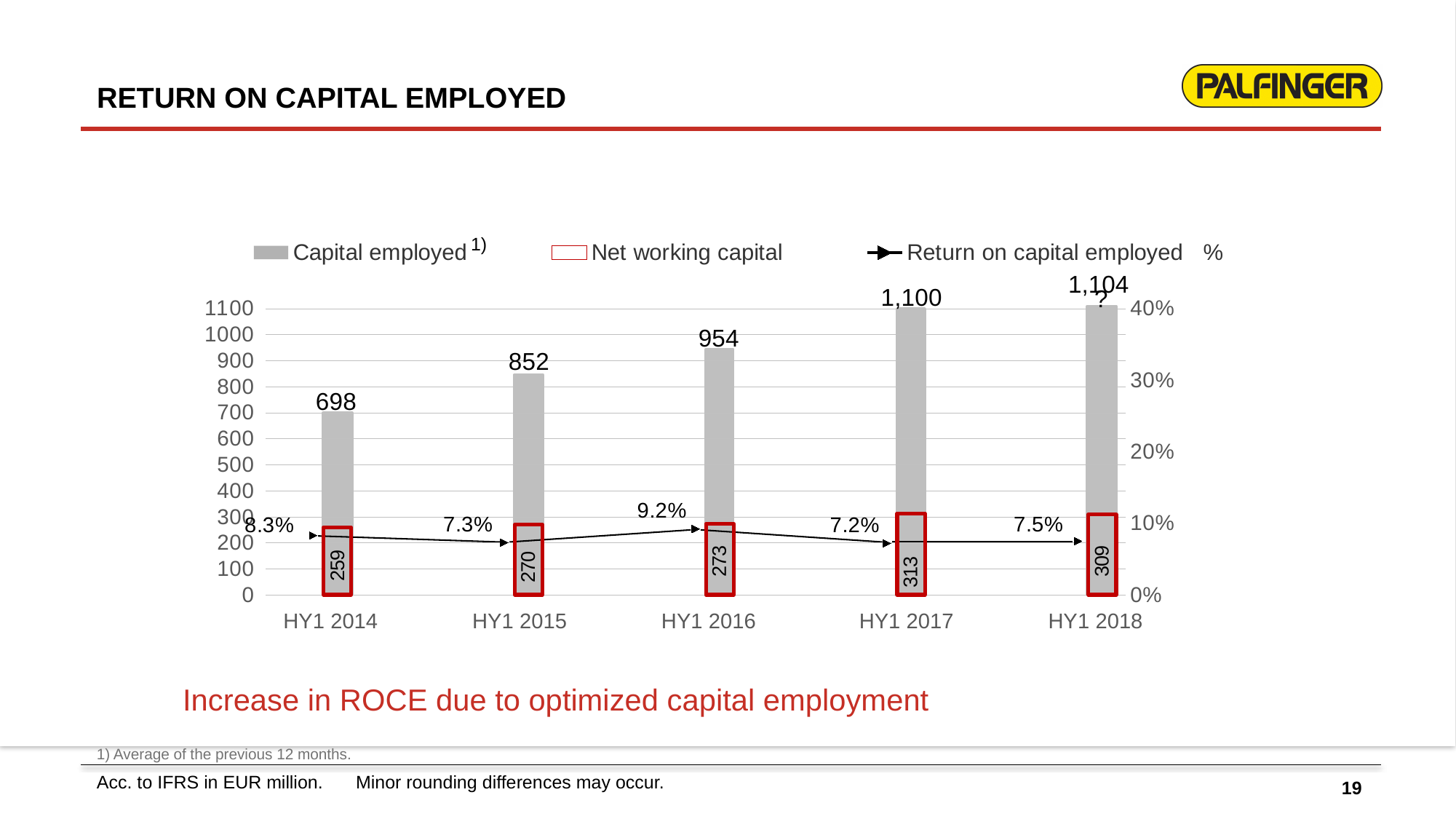
Which period has the highest return on capital employed? HY1 2016 What colour are the capital employed bars? grey Which is larger, the net working capital for HY1 2017 or for HY1 2018? HY1 2017 What is the return on capital employed for HY1 2014? 8.3% What is the net working capital for HY1 2017? 313 Does the capital employed rise or fall from HY1 2014 to HY1 2018? rise What is the difference in capital employed between HY1 2015 and HY1 2014? 154 What is the difference in return on capital employed between HY1 2016 and HY1 2017? 2.0% Which period has the lowest capital employed? HY1 2014 How many series does the legend list? 3 What is the capital employed for HY1 2016? 954 How many periods are shown on the x axis? 5